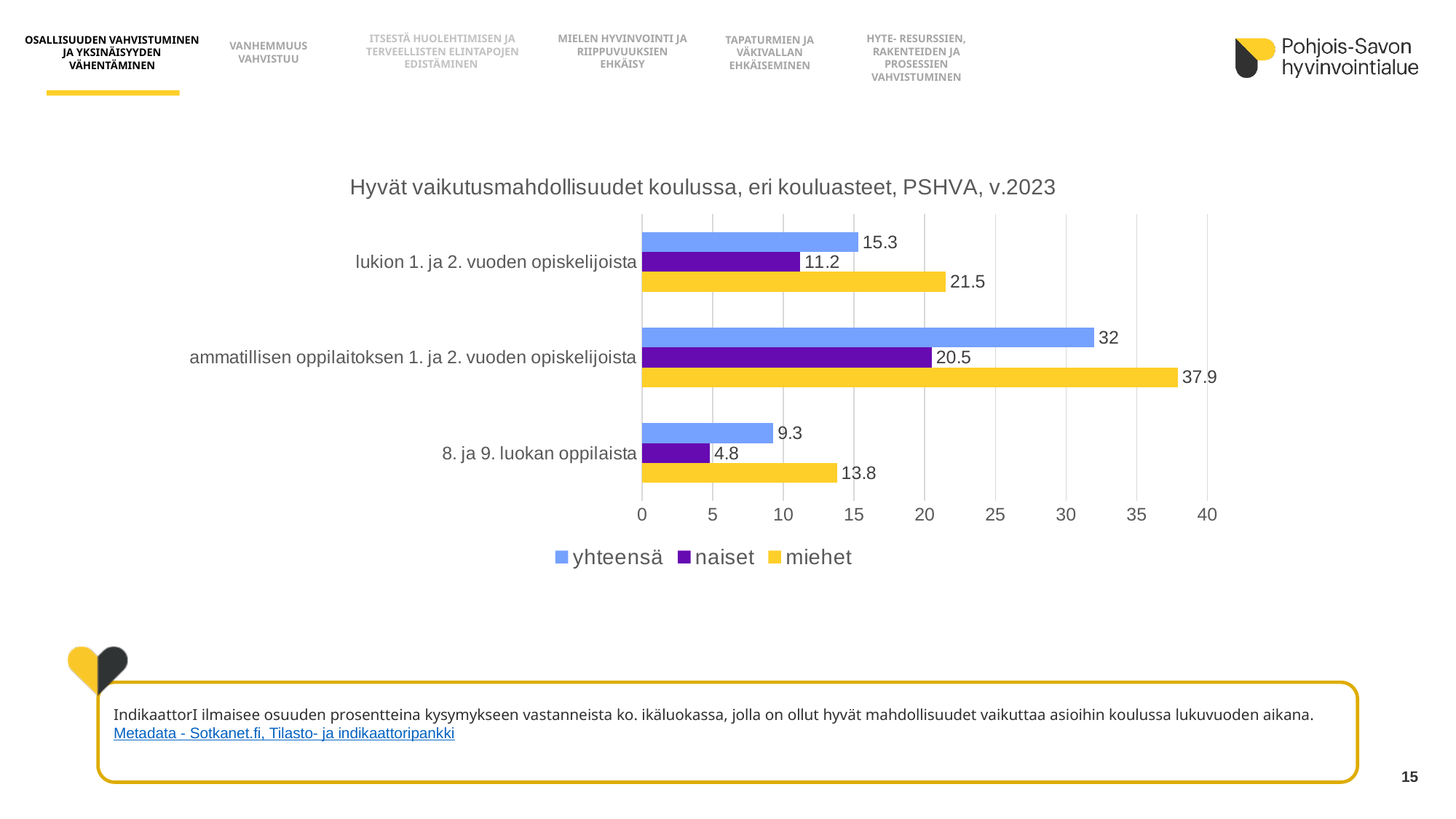
What is the title of the chart? Hyvät vaikutusmahdollisuudet koulussa, eri kouluasteet, PSHVA, v.2023 How many categories are shown on the chart? 3 What is the difference between the miehet and naiset values for lukion 1. ja 2. vuoden opiskelijoista? 10.3 What is the value for miehet among ammatillisen oppilaitoksen 1. ja 2. vuoden opiskelijoista? 37.9 Is the yhteensä value for ammatillisen oppilaitoksen 1. ja 2. vuoden opiskelijoista greater or less than 30? greater What is the yhteensä value for lukion 1. ja 2. vuoden opiskelijoista? 15.3 Which category has the highest yhteensä value? ammatillisen oppilaitoksen 1. ja 2. vuoden opiskelijoista How many series does the legend list? 3 Which is larger: the naiset value for ammatillisen oppilaitoksen 1. ja 2. vuoden opiskelijoista or the miehet value for lukion 1. ja 2. vuoden opiskelijoista? miehet value for lukion 1. ja 2. vuoden opiskelijoista What kind of chart is shown on the slide? bar chart What is the value for naiset among 8. ja 9. luokan oppilaista? 4.8 Which category has the lowest miehet value? 8. ja 9. luokan oppilaista